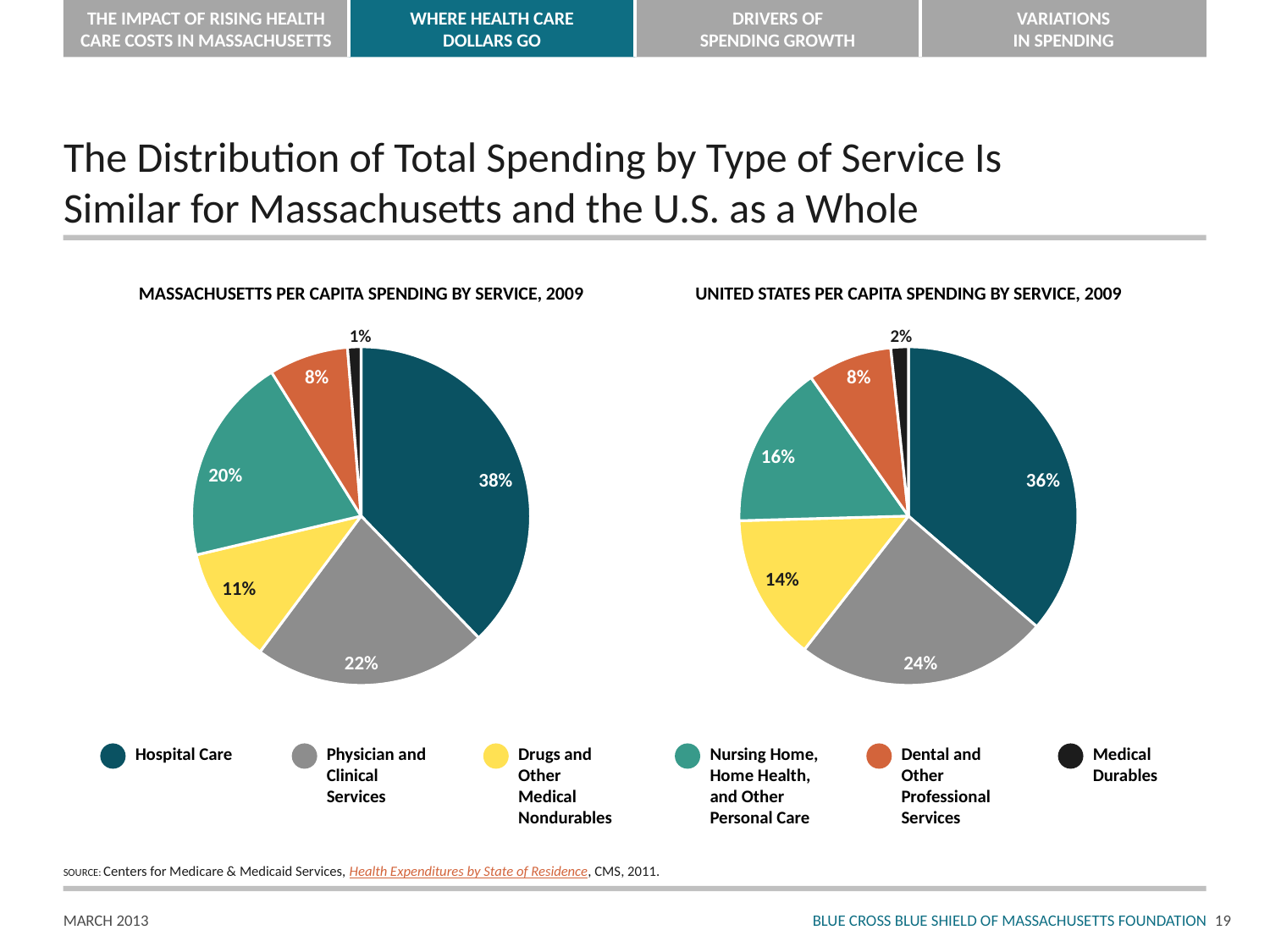
In the Massachusetts per capita spending by service, 2009 chart, what is the difference between the Physician and Clinical Services share and the Drugs and Other Medical Nondurables share? 11% What is the difference between the Hospital Care share in the Massachusetts chart and the Hospital Care share in the United States chart? 2% In the Massachusetts per capita spending by service, 2009 chart, what colour is the Dental and Other Professional Services slice? Orange Which is larger: the Nursing Home, Home Health, and Other Personal Care share in the Massachusetts chart or in the United States chart? Massachusetts In the United States per capita spending by service, 2009 chart, what share of spending goes to Physician and Clinical Services? 24% How many categories does the legend list for the pie charts? 6 In the United States per capita spending by service, 2009 chart, what share goes to Drugs and Other Medical Nondurables? 14% In the Massachusetts per capita spending by service, 2009 chart, what share of spending goes to Hospital Care? 38% In the Massachusetts per capita spending by service, 2009 chart, which category has the largest share? Hospital Care What type of chart is used to show United States per capita spending by service, 2009? Pie chart In the Massachusetts per capita spending by service, 2009 chart, what share goes to Nursing Home, Home Health, and Other Personal Care? 20% In the United States per capita spending by service, 2009 chart, which category has the smallest share? Medical Durables